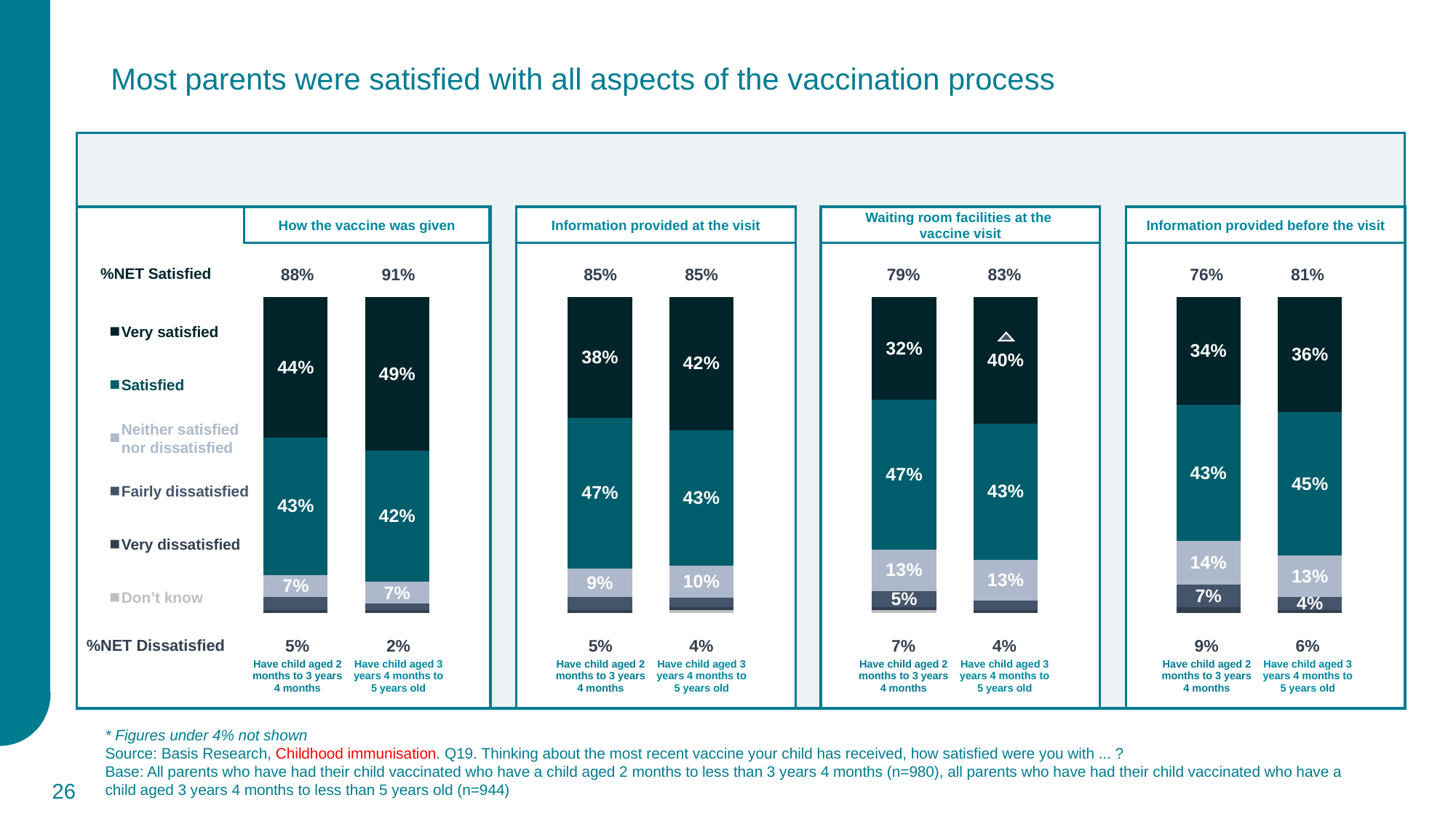
In the 'Information provided at the visit' chart, what is the %NET Satisfied for parents with a child aged 3 years 4 months to 5 years old? 85% In the 'How the vaccine was given' chart, what is the combined 'Very satisfied' and 'Satisfied' percentage for parents with a child aged 3 years 4 months to 5 years old? 91% In the 'How the vaccine was given' chart, what percentage of parents with a child aged 2 months to 3 years 4 months were very satisfied? 44% How many bars are shown in the 'Information provided before the visit' chart? 2 In the 'Waiting room facilities at the vaccine visit' chart, what is the difference in the 'Very satisfied' percentage between the two age groups? 8% How many entries does the legend list? 6 In the 'Information provided before the visit' chart, what is the %NET Dissatisfied for parents with a child aged 2 months to 3 years 4 months? 9% In the 'Waiting room facilities at the vaccine visit' chart, what percentage of parents with a child aged 2 months to 3 years 4 months were fairly dissatisfied? 5% What kind of chart is used to show satisfaction with each aspect of the vaccination process? Stacked bar chart Across the four charts, which aspect has the highest %NET Satisfied for parents with a child aged 3 years 4 months to 5 years old? How the vaccine was given Across the four charts, which aspect has the lowest %NET Satisfied for parents with a child aged 2 months to 3 years 4 months? Information provided before the visit In the 'Information provided at the visit' chart, which age group has the larger 'Satisfied' percentage? Have child aged 2 months to 3 years 4 months